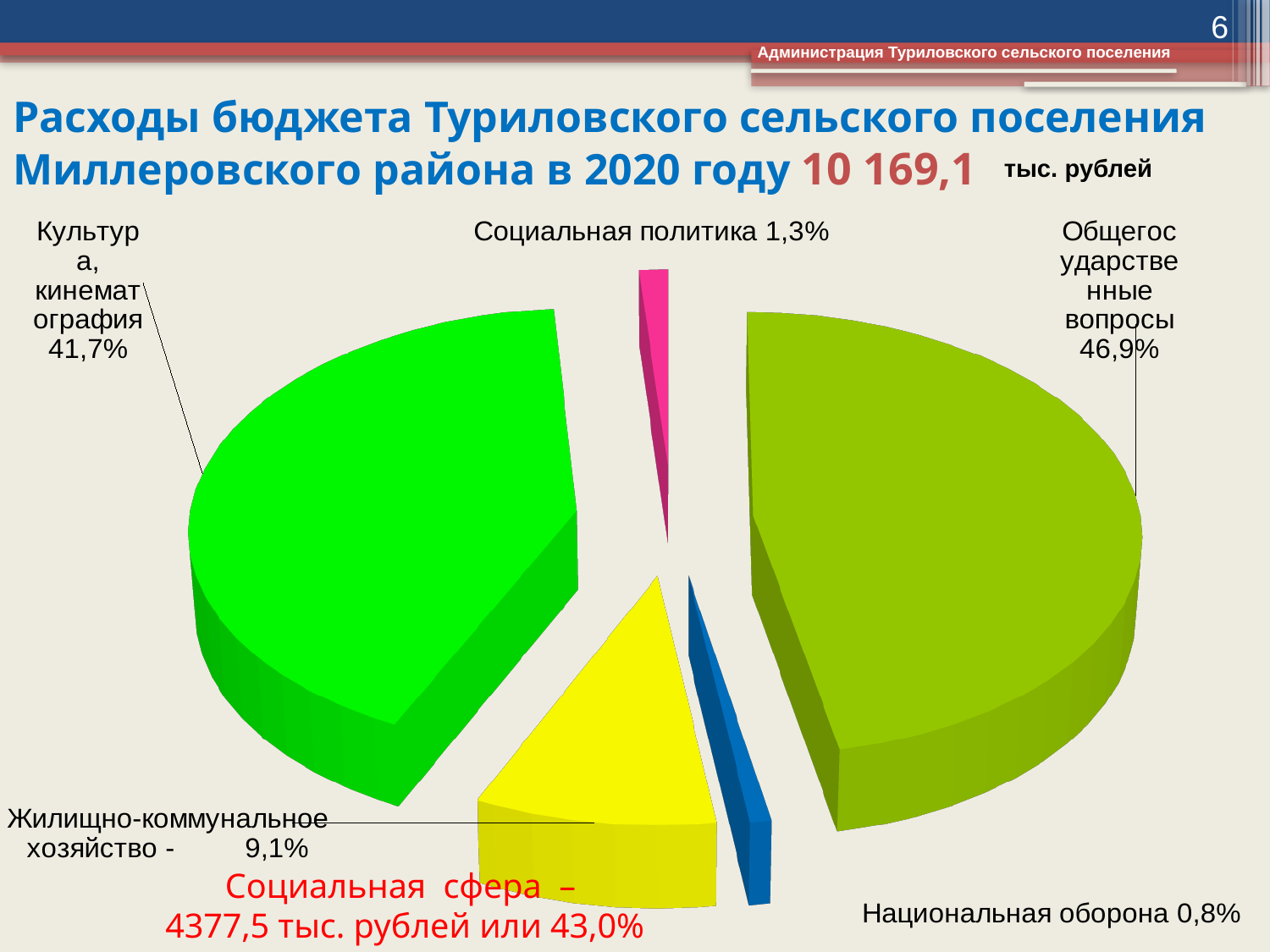
What share of the pie does Общегосударственные вопросы have? 46,9% What is the value shown for Жилищно-коммунальное хозяйство? 9,1% Which category has the largest share of the pie? Общегосударственные вопросы What is the difference between the shares of Общегосударственные вопросы and Культура, кинематография? 5,2% What is the value shown for Национальная оборона? 0,8% What kind of chart is shown on the slide? pie chart What share of the pie does Культура, кинематография have? 41,7% What total budget expenditure amount (in тыс. рублей) is stated in the slide title? 10 169,1 Which category has the smallest share of the pie? Национальная оборона How many slices does the pie chart have? 5 Which is larger: the share for Жилищно-коммунальное хозяйство or the share for Социальная политика? Жилищно-коммунальное хозяйство What is the value shown for Социальная политика? 1,3%